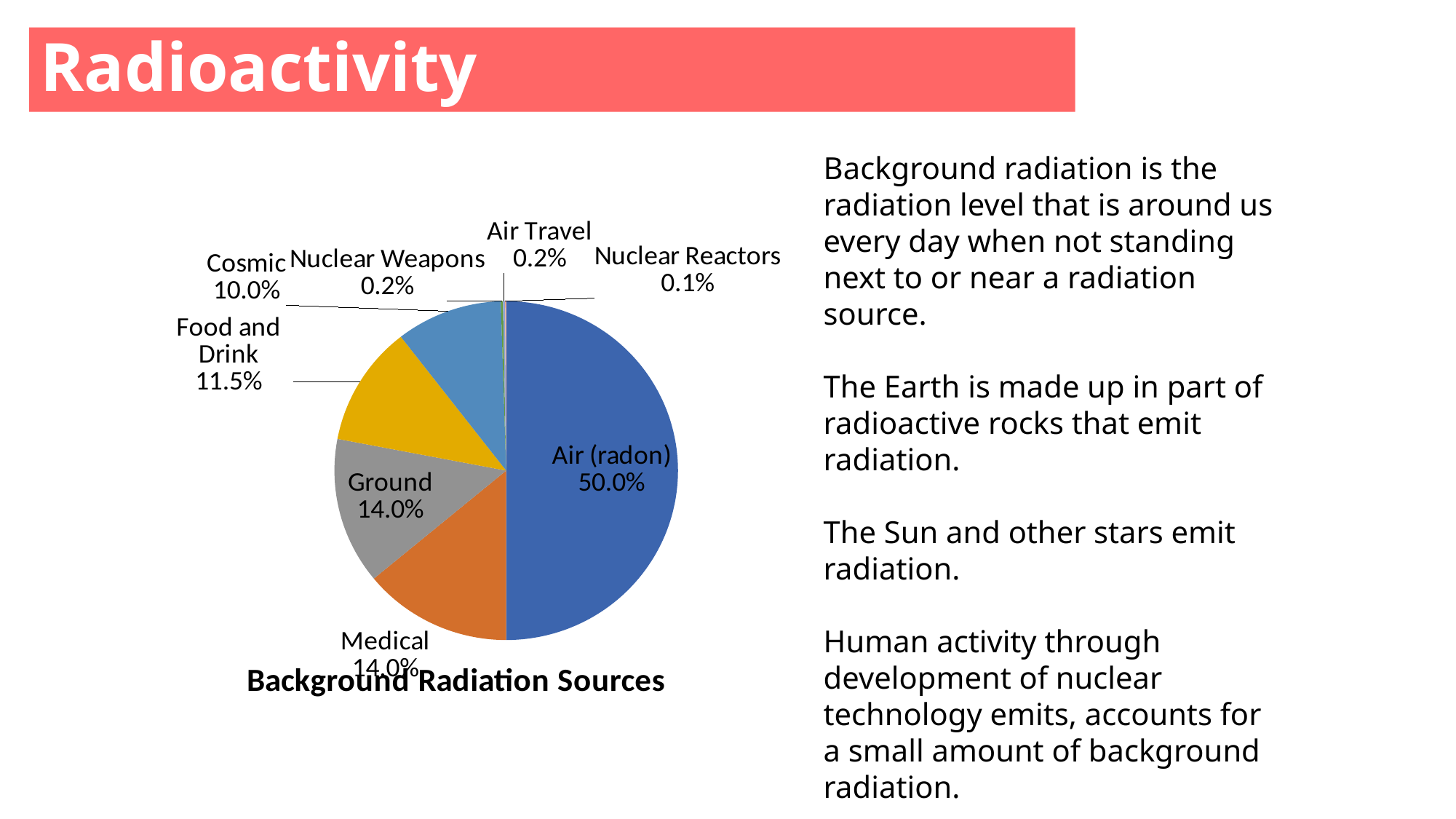
What type of chart is shown on the slide? pie chart What is the title of the chart? Background Radiation Sources What is the value shown for Food and Drink? 11.5% What is the value shown for Nuclear Reactors? 0.1% What is the value shown for Cosmic? 10.0% Which is larger, the Food and Drink slice or the Cosmic slice? Food and Drink What is the combined share of Medical and Ground? 28.0% What is the difference between the Air (radon) share and the Ground share? 36.0% Which source has the largest slice of the pie? Air (radon) What share of background radiation comes from Air (radon)? 50.0% How many sources are shown in the pie chart? 8 Which source has the smallest slice of the pie? Nuclear Reactors